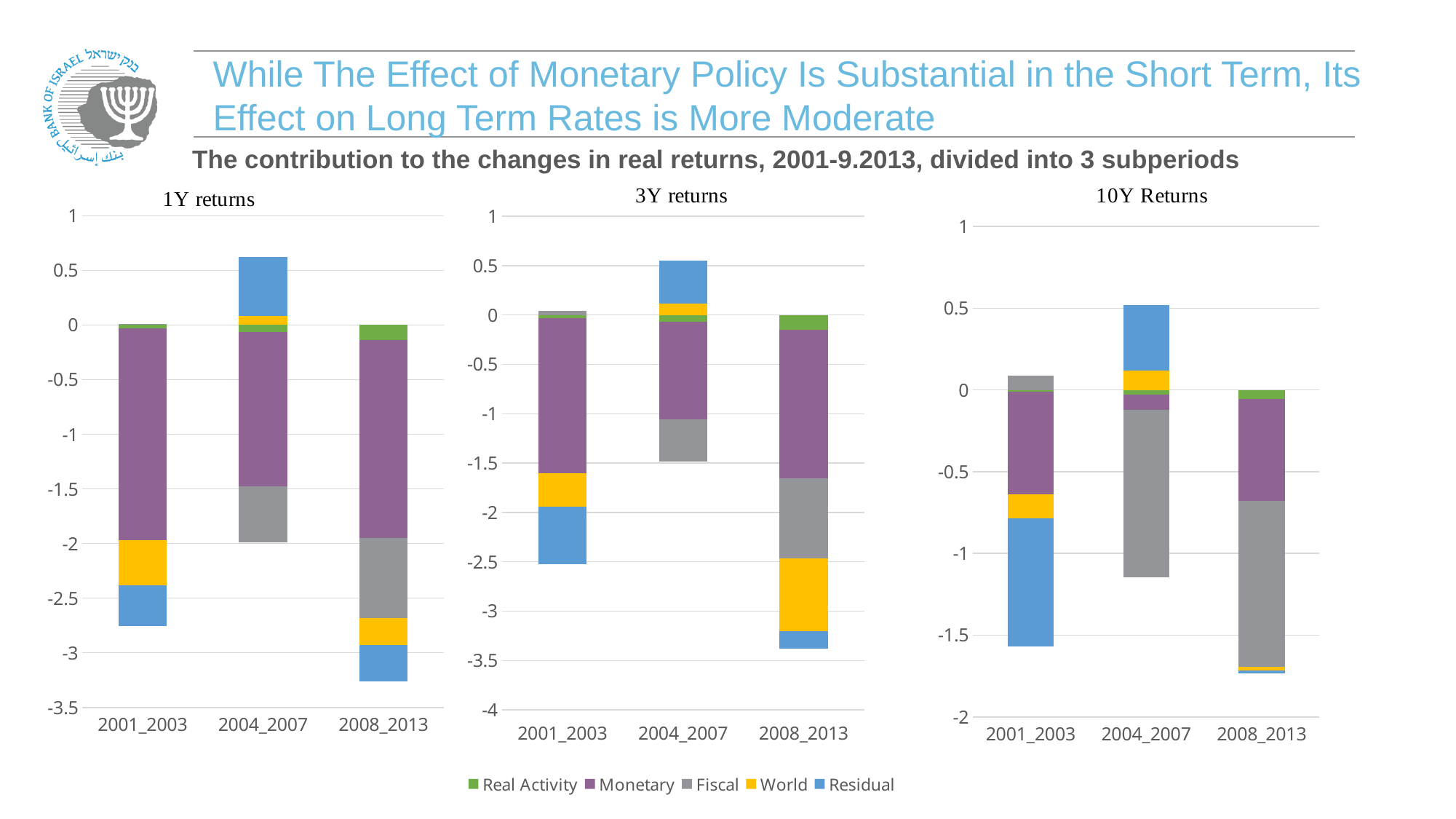
In the 1Y returns chart, which subperiod has a positive Residual contribution? 2004_2007 In the 1Y returns chart, is the bottom of the 2008_2013 stacked bar greater or less than -3? less In the 10Y Returns chart, is the top of the 2004_2007 stacked bar greater or less than 0? greater How many subperiods (categories) are shown on the x axis of the 3Y returns chart? 3 In the 1Y returns chart, is the Monetary segment larger in magnitude for 2001_2003 or for 2004_2007? 2001_2003 In the 10Y Returns chart, is the bottom of the 2008_2013 stacked bar greater or less than -1.5? less How many series does the legend list? 5 In the 1Y returns chart, is the Fiscal segment larger in magnitude for 2004_2007 or for 2008_2013? 2008_2013 What kind of chart is the 1Y returns chart? stacked bar chart Which colour represents Fiscal in the legend? grey